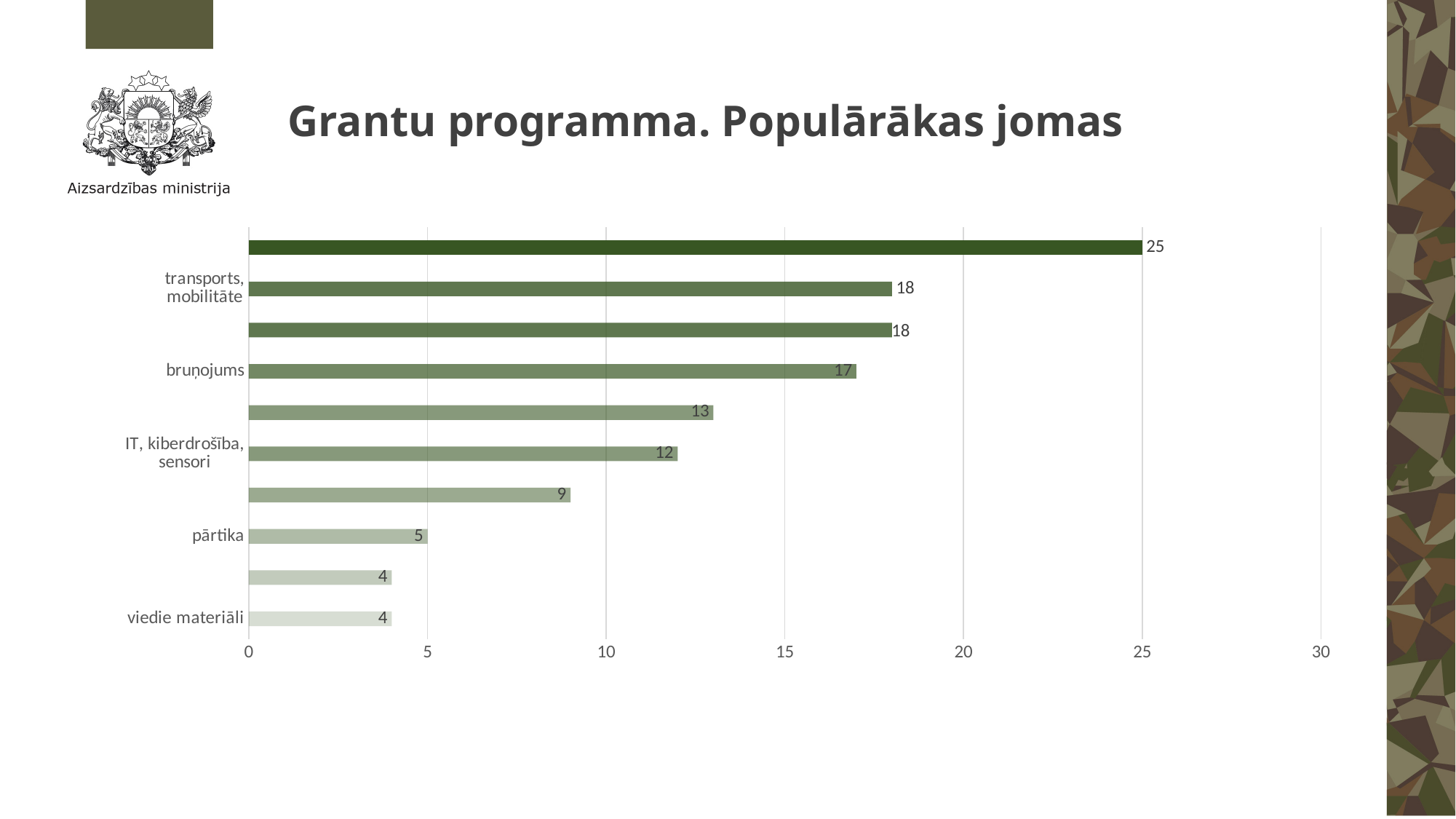
What is the value for "viedie materiāli"? 4 What is the value for "IT, kiberdrošība, sensori"? 12 What is the value for "pārtika"? 5 Is the value for "bruņojums" greater or less than 15? greater What is the difference between the values for "bruņojums" and "pārtika"? 12 What is the value for "transports, mobilitāte"? 18 How many bars are plotted in the chart? 10 What is the largest value shown on any bar in the chart? 25 What kind of chart is shown on the slide? bar chart What is the value for "bruņojums"? 17 What is the title of the slide? Grantu programma. Populārākas jomas Which has a larger value, "transports, mobilitāte" or "IT, kiberdrošība, sensori"? transports, mobilitāte